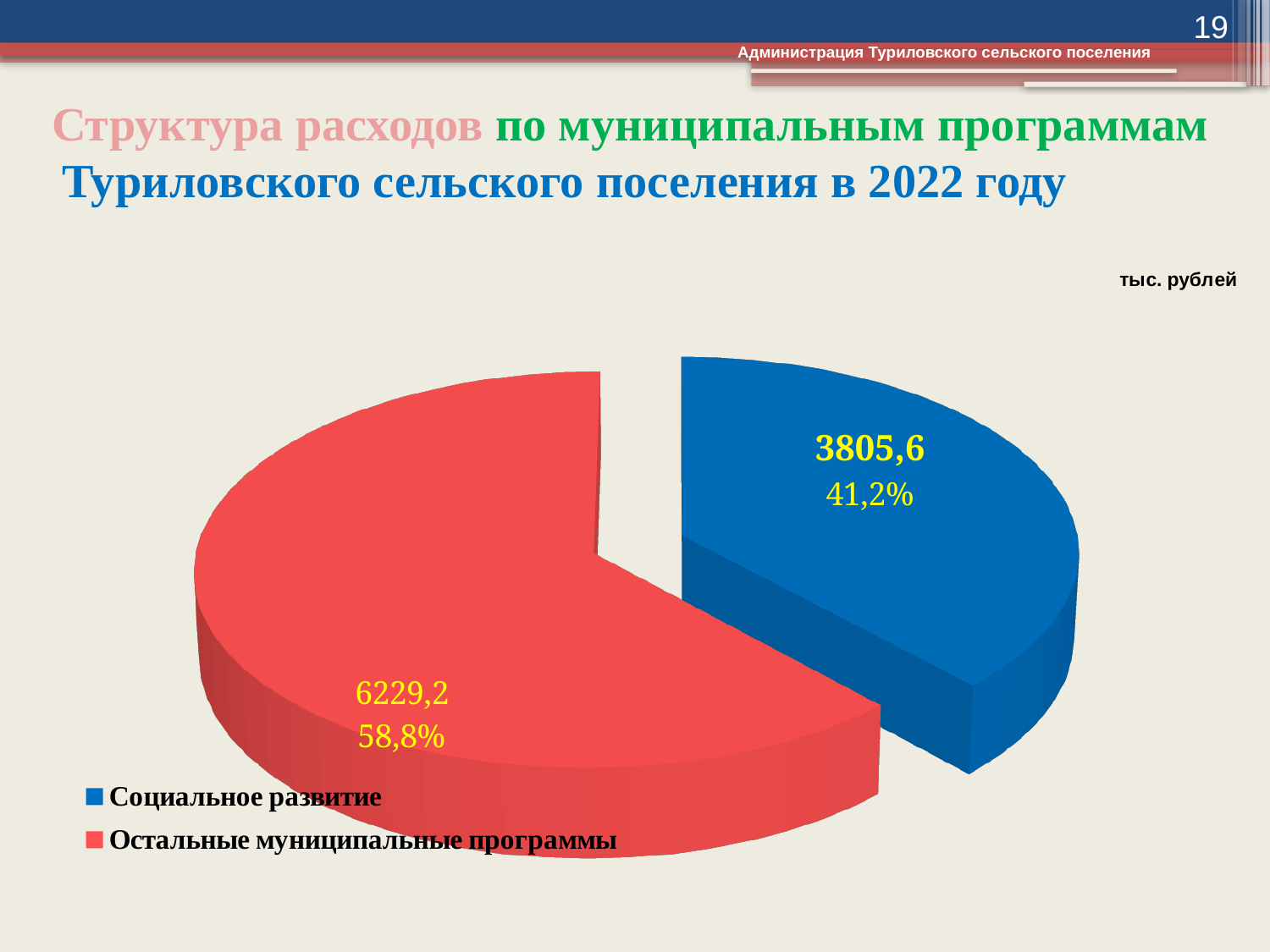
What kind of chart is shown on the slide? Pie chart What is the total of the two slices? 10034,8 Which category has the smallest slice? Социальное развитие What is the difference between the values for Остальные муниципальные программы and Социальное развитие? 2423,6 What share of the pie does Остальные муниципальные программы represent? 58,8% What is the value for Социальное развитие? 3805,6 Which category has the largest slice? Остальные муниципальные программы What is the value for Остальные муниципальные программы? 6229,2 What share of the pie does Социальное развитие represent? 41,2% Which is larger: Социальное развитие or Остальные муниципальные программы? Остальные муниципальные программы What unit is indicated for the chart values? тыс. рублей How many slices does the pie chart have? 2